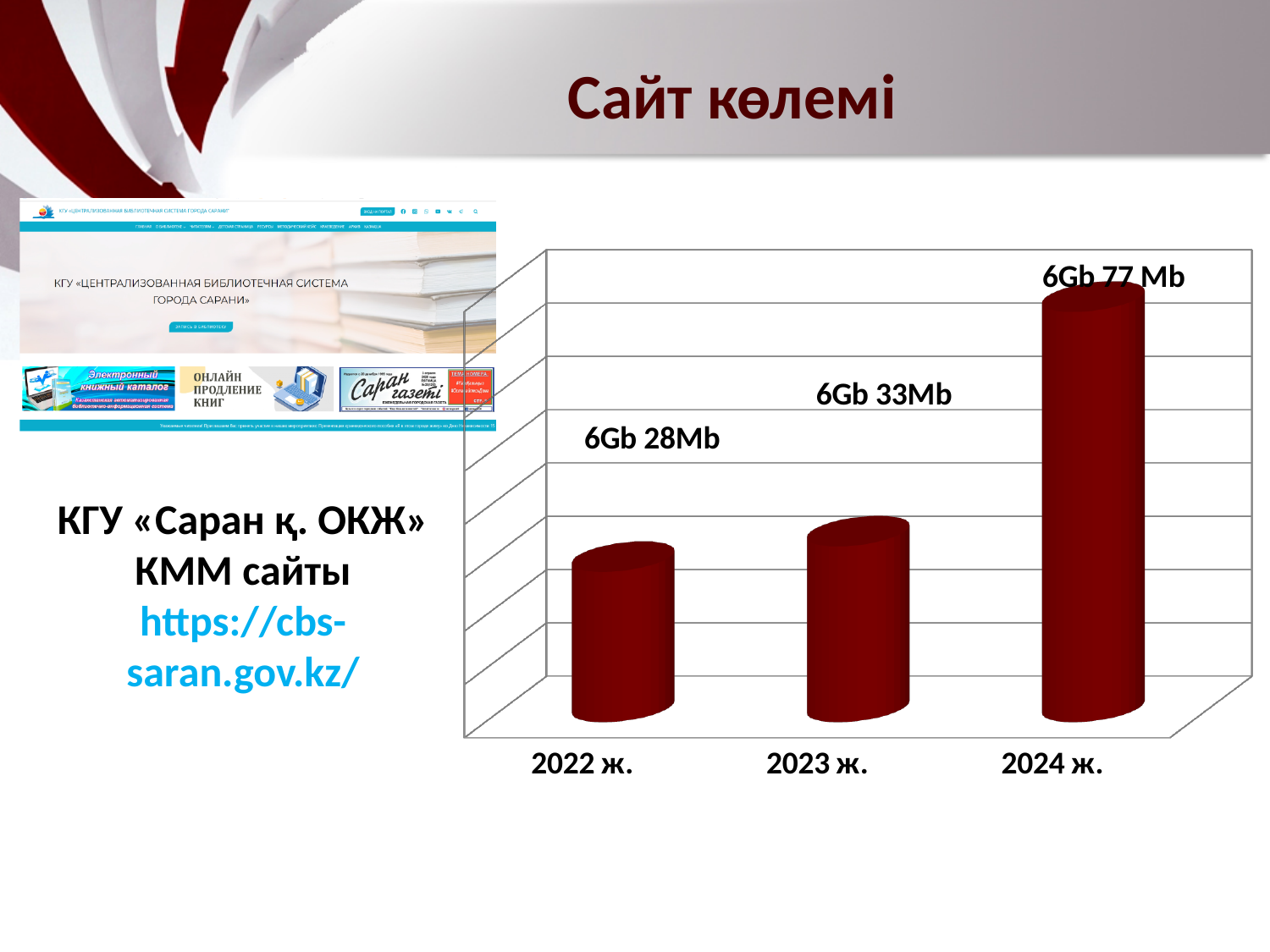
Do the values rise or fall from 2022 ж. to 2024 ж.? Rise Which year has the highest value? 2024 ж. How many years are shown on the chart? 3 What is the value shown for 2024 ж.? 6Gb 77 Mb What is the value shown for 2022 ж.? 6Gb 28Mb Which year has the lowest value? 2022 ж. Which is larger, the value for 2023 ж. or the value for 2024 ж.? 2024 ж. What kind of chart is shown on the slide? Bar chart What colour are the bars in the chart? Dark red What is the value shown for 2023 ж.? 6Gb 33Mb By how many Mb does the value for 2024 ж. exceed the value for 2022 ж.? 49 Mb By how many Mb does the value for 2023 ж. exceed the value for 2022 ж.? 5 Mb